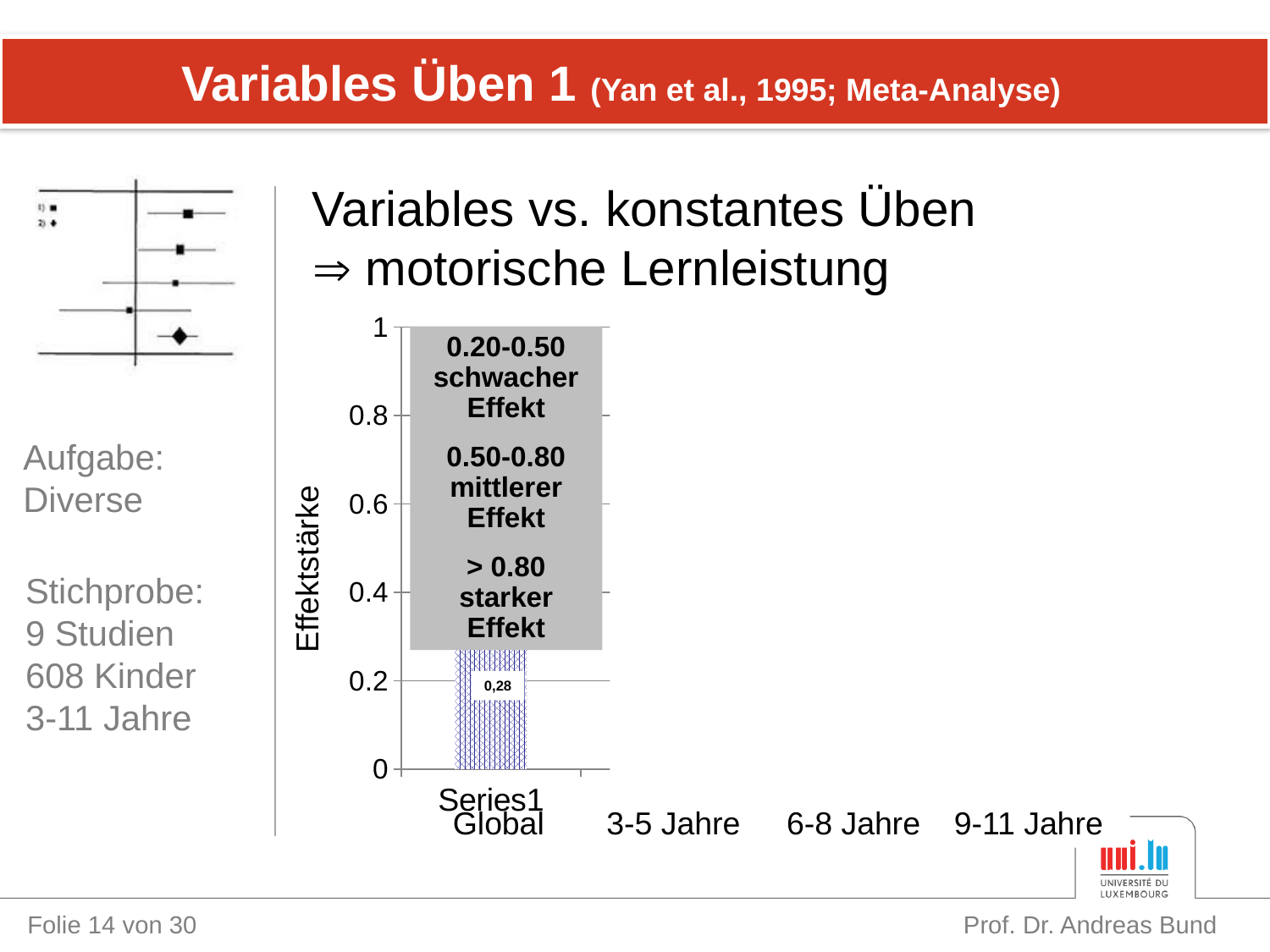
What value is printed on the bar in the chart? 0,28 How many bars are plotted in the chart? 1 Is the value of the plotted bar greater or less than 0.2? greater Is the value of the plotted bar greater or less than 0.4? less What is the label of the y axis of the chart? Effektstärke According to the grey box in the chart, which effect category does a value of 0.28 fall into? schwacher Effekt What kind of chart is shown on the slide? bar chart